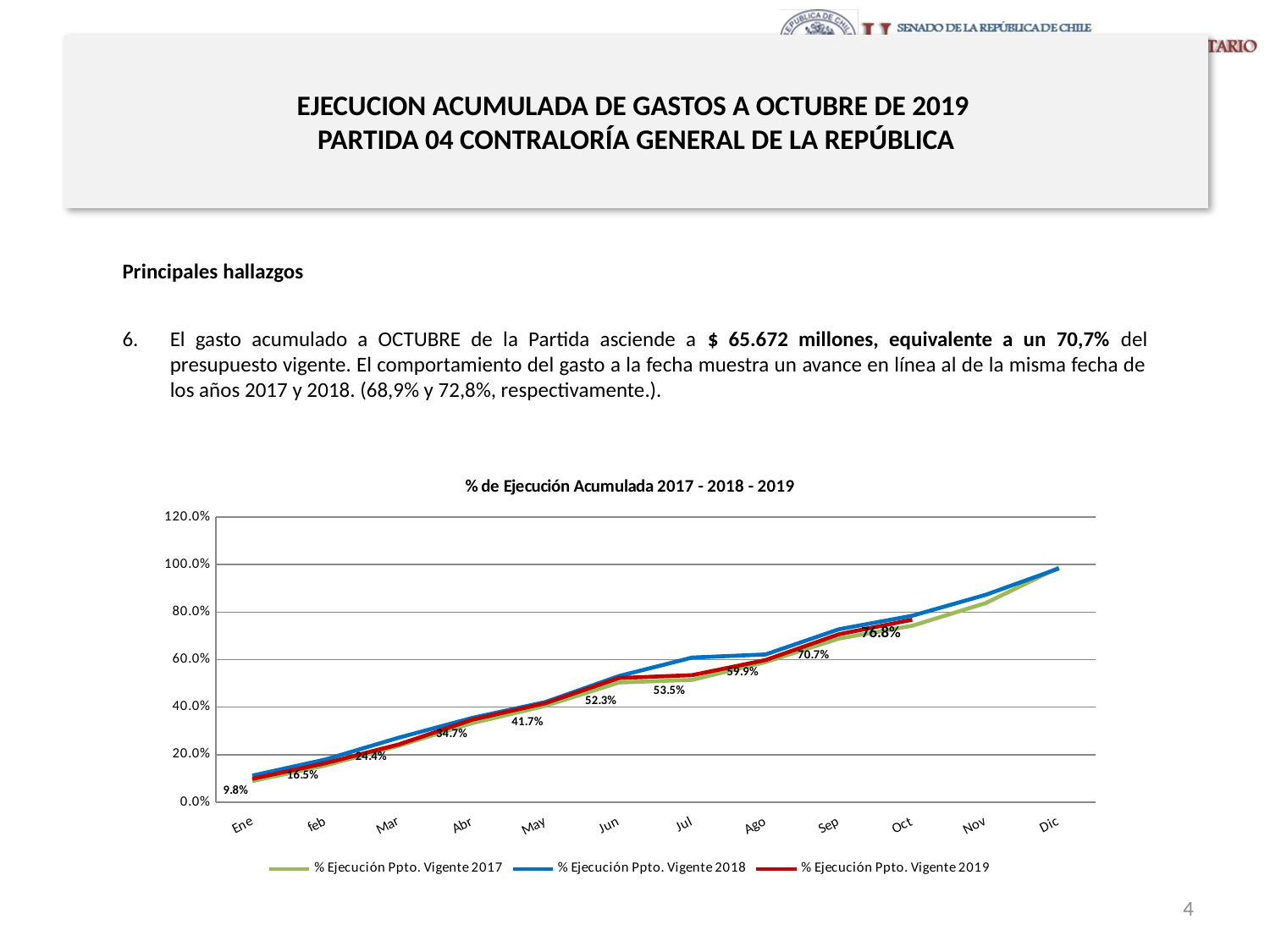
Is the % Ejecución Ppto. Vigente 2018 value for Dic greater or less than 80.0%? greater What is the % Ejecución Ppto. Vigente 2019 value for Jun? 52.3% What is the % Ejecución Ppto. Vigente 2019 value for Abr? 34.7% What is the % Ejecución Ppto. Vigente 2019 value for Ago? 59.9% What is the % Ejecución Ppto. Vigente 2019 value for Ene? 9.8% What is the title of the chart? % de Ejecución Acumulada 2017 - 2018 - 2019 How many series does the chart legend list? 3 What kind of chart is shown on the slide? line chart By how many percentage points does the 2019 series increase from Jun to Jul? 1.2 How many months are shown on the x axis of the chart? 12 By how many percentage points does the 2019 series increase from Ene to May? 31.9 Do the values of the 2019 series rise or fall from Ene to Oct? rise